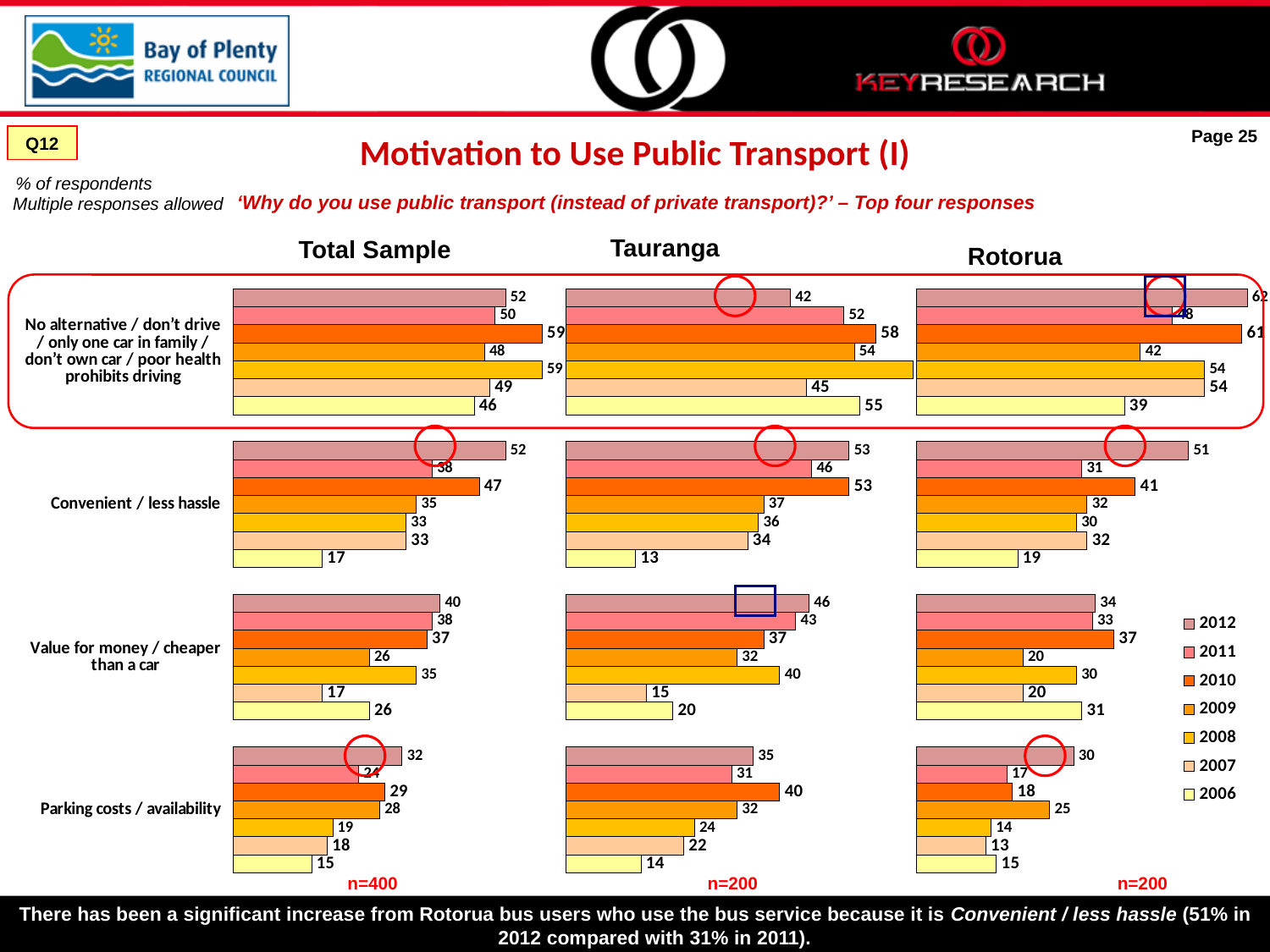
In the Total Sample chart, what is the 2006 value for Convenient / less hassle? 17 In the Tauranga chart, which year has the lowest value for Convenient / less hassle? 2006 What kind of chart is used for the Tauranga data? Bar chart In the Tauranga chart, what is the difference between the 2012 and 2007 values for Value for money / cheaper than a car? 31 How many series does the legend list? 7 In the Total Sample chart, which is larger for Parking costs / availability: the 2012 value or the 2011 value? 2012 In the Rotorua chart, what is the difference between the 2012 and 2011 values for Convenient / less hassle? 20 How many response categories are shown in the Total Sample chart? 4 In the Tauranga chart, what is the 2010 value for Parking costs / availability? 40 In the Rotorua chart, what is the 2012 value for No alternative / don't drive / only one car in family / don't own car / poor health prohibits driving? 62 In the Rotorua chart, what is the 2012 value for Convenient / less hassle? 51 In the Rotorua chart, which year has the highest value for Parking costs / availability? 2012